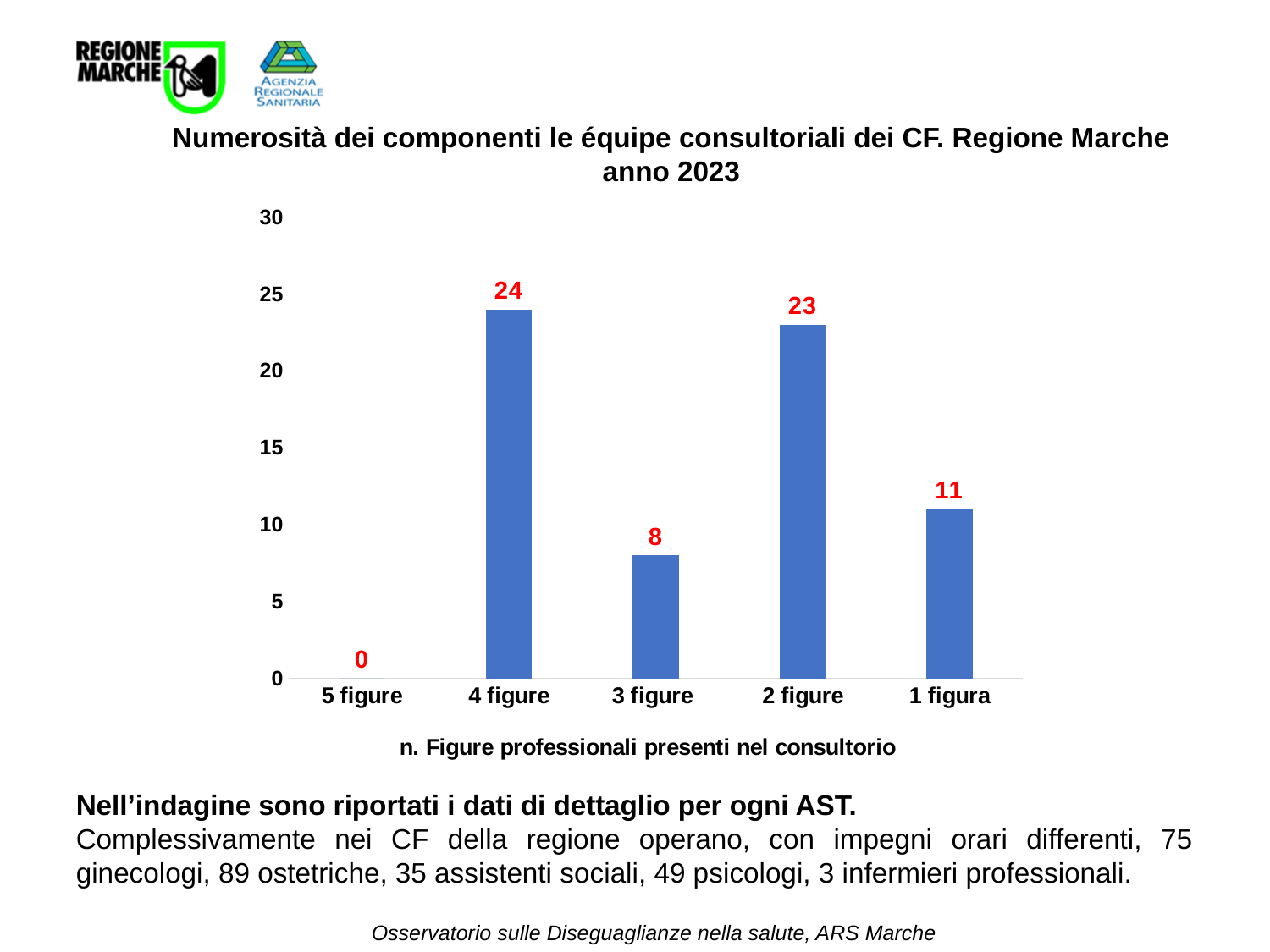
What is the value for "3 figure"? 8 What is the label of the x axis? n. Figure professionali presenti nel consultorio What is the difference between the values for "4 figure" and "3 figure"? 16 Which category has the lowest value? 5 figure What is the value for "5 figure"? 0 What kind of chart is shown on the slide? Bar chart What is the value for "4 figure"? 24 How many categories are shown on the x axis? 5 What is the value for "2 figure"? 23 What is the value for "1 figura"? 11 Which is larger, the value for "1 figura" or the value for "3 figure"? 1 figura Which category has the highest value? 4 figure